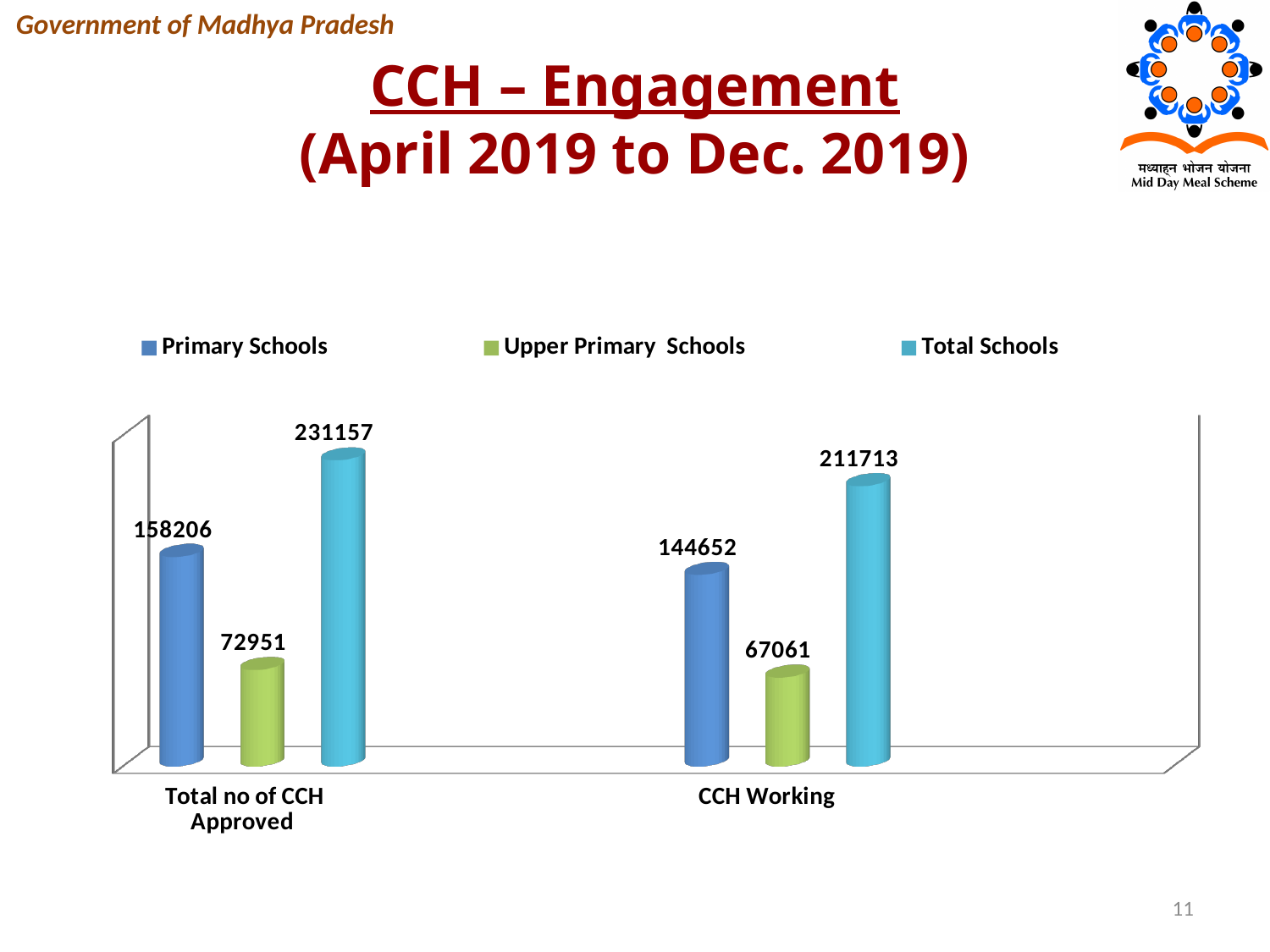
What is the value for Primary Schools in the Total no of CCH Approved category? 158206 What is the value for Total Schools in the CCH Working category? 211713 How many series does the legend list? 3 Which series has the lowest value in the CCH Working category? Upper Primary Schools What is the value for Upper Primary Schools in the CCH Working category? 67061 Which series has the highest value in the Total no of CCH Approved category? Total Schools What is the difference between Total Schools for Total no of CCH Approved and Total Schools for CCH Working? 19444 What is the difference between Primary Schools for Total no of CCH Approved and Primary Schools for CCH Working? 13554 What is the value for Total Schools in the Total no of CCH Approved category? 231157 How many categories are shown on the x axis? 2 What kind of chart is shown on the slide? Bar chart Which is larger: Upper Primary Schools for Total no of CCH Approved or Upper Primary Schools for CCH Working? Total no of CCH Approved